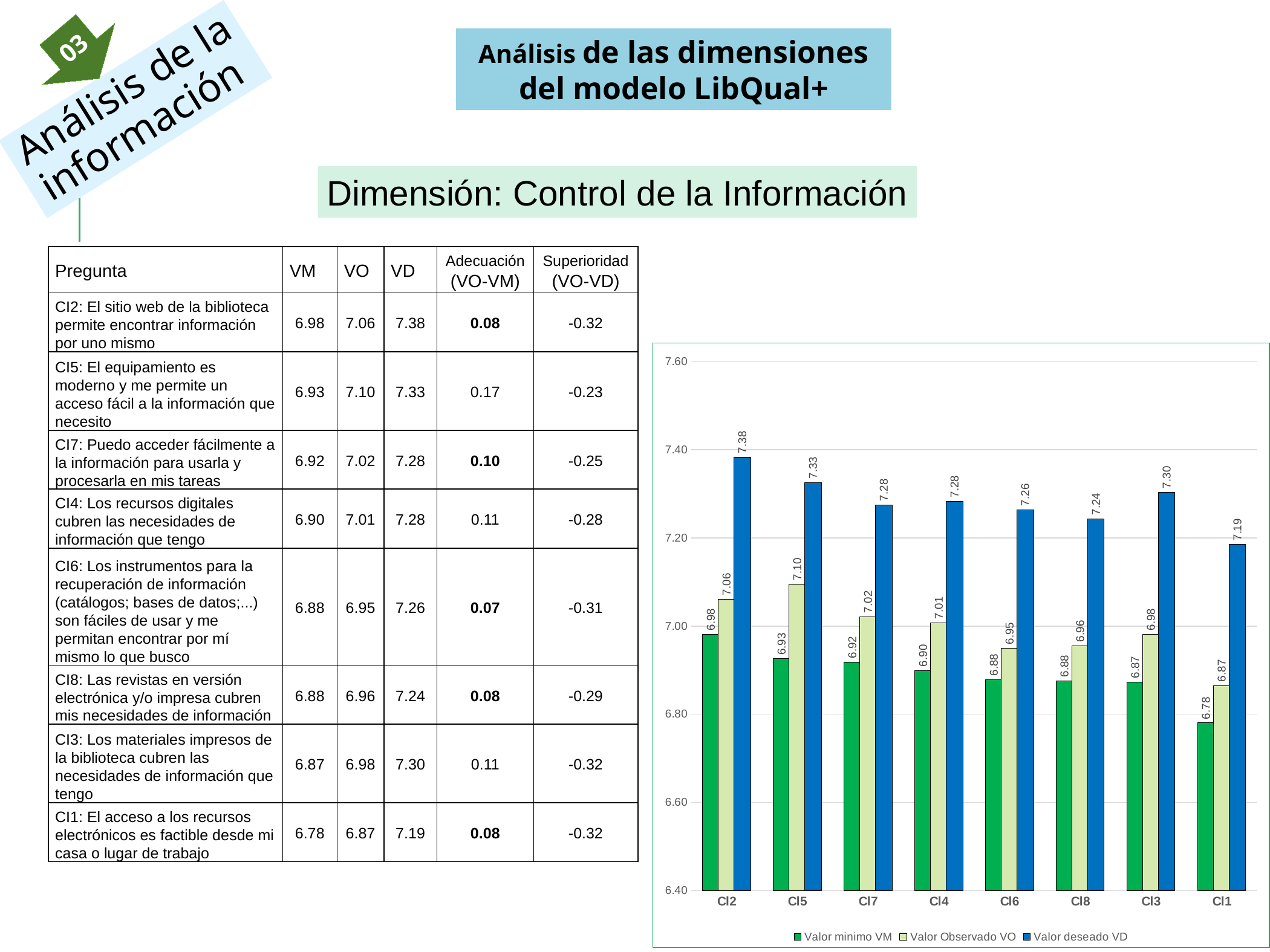
Which category has the lowest Valor minimo VM value? CI1 How many series does the chart legend list? 3 What is the Valor minimo VM value for CI1? 6.78 What is the Valor Observado VO value for CI5? 7.10 Which is larger, the Valor Observado VO value for CI2 or for CI8? CI2 What is the Valor deseado VD value for CI2? 7.38 What are the three series listed in the chart legend? Valor minimo VM, Valor Observado VO, Valor deseado VD Is the Valor deseado VD value for CI1 greater or less than 7.20? less What kind of chart is shown on the slide? bar chart What is the difference between the Valor deseado VD and Valor Observado VO values for CI3? 0.32 Which category has the highest Valor deseado VD value? CI2 How many categories are shown on the x axis of the chart? 8